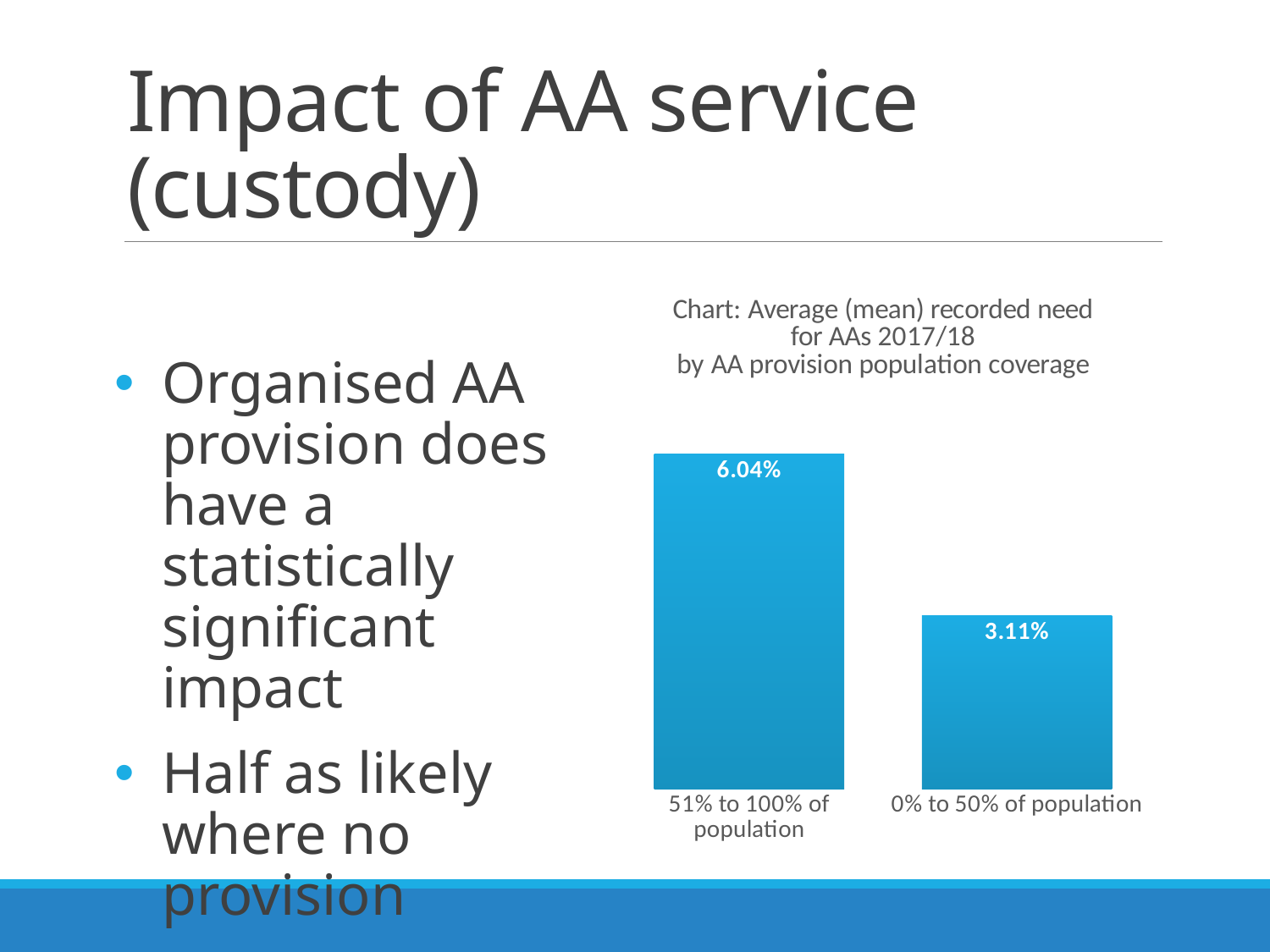
What is the difference between the values for '51% to 100% of population' and '0% to 50% of population'? 2.93% How many categories are shown in the chart? 2 Which category has the lowest average recorded need for AAs? 0% to 50% of population Do the values rise or fall from left to right across the categories? Fall What is the average recorded need for AAs for the '51% to 100% of population' category? 6.04% Which category has the highest average recorded need for AAs? 51% to 100% of population What is the average recorded need for AAs for the '0% to 50% of population' category? 3.11% What kind of chart is shown on the slide? Bar chart What colour are the bars in the chart? Blue Which is larger: the value for '51% to 100% of population' or the value for '0% to 50% of population'? 51% to 100% of population What is the title of the chart? Chart: Average (mean) recorded need for AAs 2017/18 by AA provision population coverage